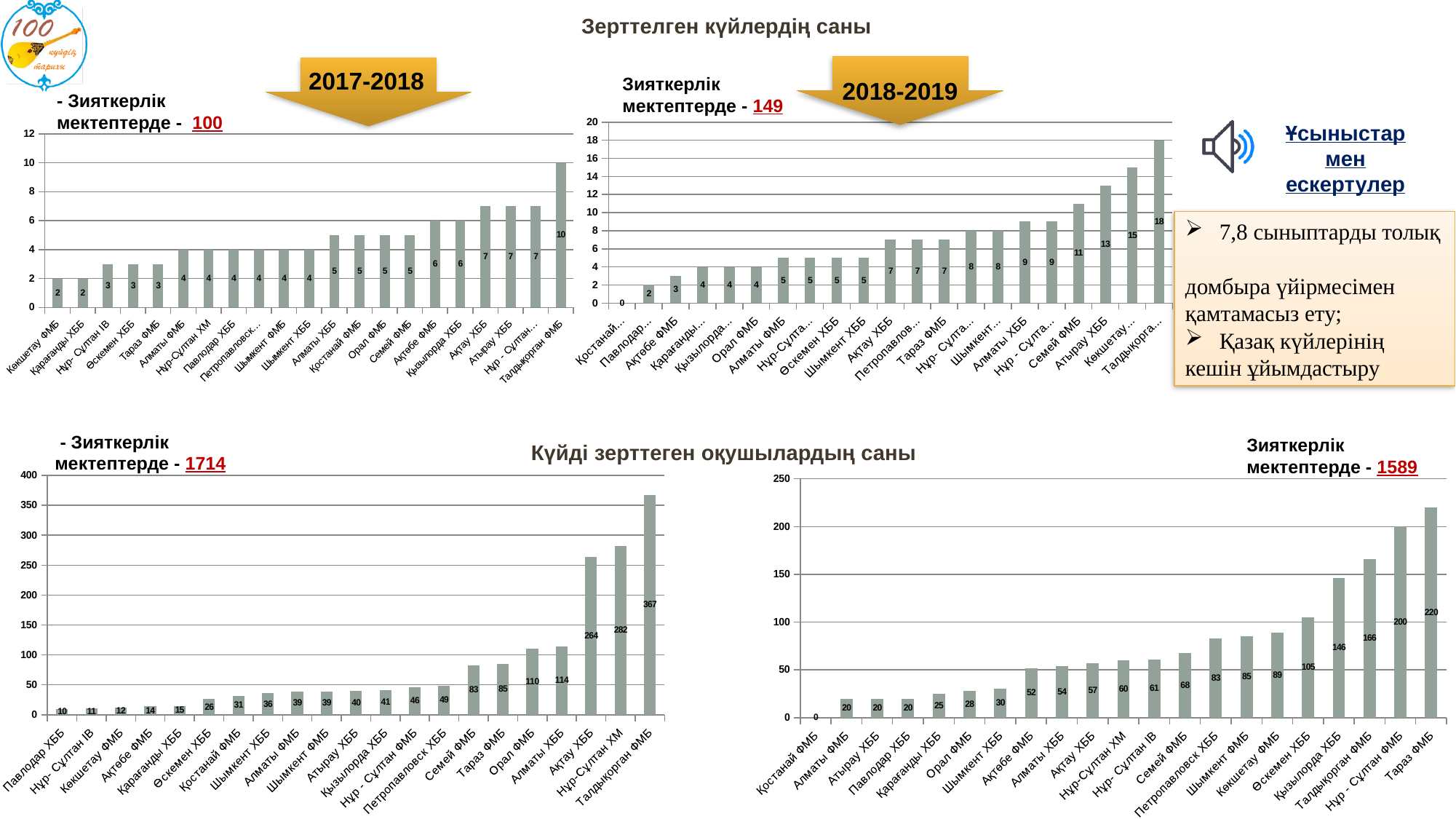
In the top-left chart (2017-2018, Зерттелген күйлердің саны), what is the value for Талдықорған ФМБ? 10 In the bottom-right chart (Күйді зерттеген оқушылардың саны, 1589), which category has the highest value? Тараз ФМБ In the bottom-left chart (Күйді зерттеген оқушылардың саны, 1714), which is larger: the value for Орал ФМБ or the value for Тараз ФМБ? Орал ФМБ In the bottom-right chart (Күйді зерттеген оқушылардың саны, 1589), what is the value for Қызылорда ХББ? 146 In the bottom-left chart (Күйді зерттеген оқушылардың саны, 1714), which category has the lowest value? Павлодар ХББ In the top-right chart (2018-2019, Зерттелген күйлердің саны), how many categories are plotted? 21 In the top-right chart (2018-2019, Зерттелген күйлердің саны), what is the value for Атырау ХББ? 13 In the top-left chart (2017-2018, Зерттелген күйлердің саны), which category has the highest value? Талдықорған ФМБ In the top-right chart (2018-2019, Зерттелген күйлердің саны), what is the difference between the values for Семей ФМБ and Ақтөбе ФМБ? 8 What type of chart is the bottom-right chart (Күйді зерттеген оқушылардың саны, 1589)? Bar chart In the bottom-right chart (Күйді зерттеген оқушылардың саны, 1589), what is the difference between the values for Тараз ФМБ and Нұр-Сұлтан ФМБ? 20 In the bottom-left chart (Күйді зерттеген оқушылардың саны, 1714), what is the value for Нұр-Сұлтан ХМ? 282